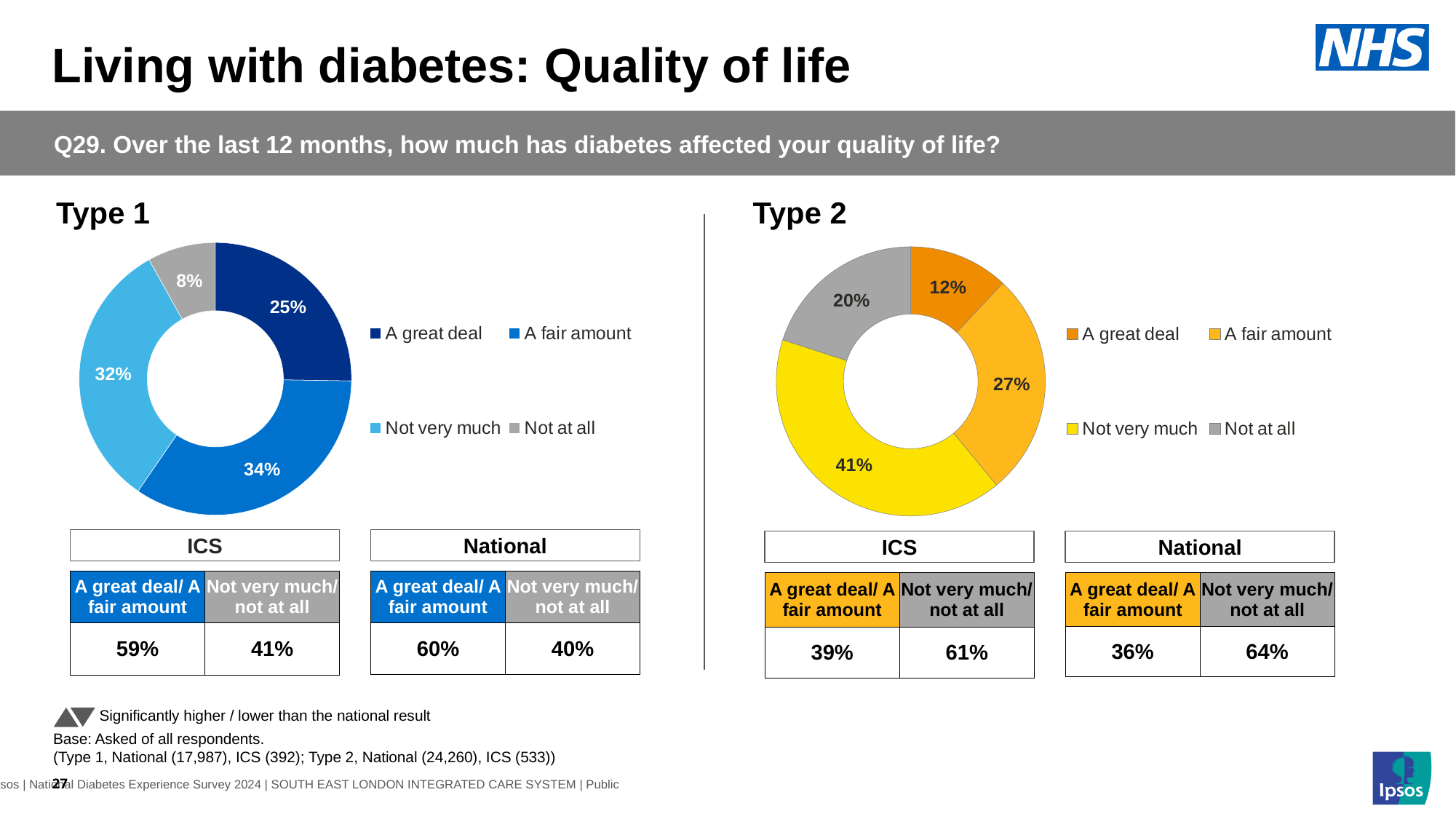
In the Type 1 chart, what is the 'Not at all' share? 8% In the Type 2 chart, which is larger: 'A fair amount' or 'Not at all'? A fair amount How many categories does the Type 1 chart show? 4 In the Type 1 chart, what percentage of respondents said diabetes affected their quality of life 'A great deal'? 25% In the Type 2 chart, what percentage of respondents said 'Not very much'? 41% In the Type 2 chart, what colour represents 'Not very much'? Yellow In the Type 2 chart, what is the combined share of 'A great deal' and 'A fair amount'? 39% What type of chart is used for Type 2? Doughnut chart In the Type 1 chart, which category has the smallest share? Not at all In the Type 2 chart, which category has the largest share? Not very much How many legend entries does the Type 1 chart have? 4 In the Type 1 chart, what is the difference between the 'A fair amount' and 'A great deal' shares? 9 percentage points